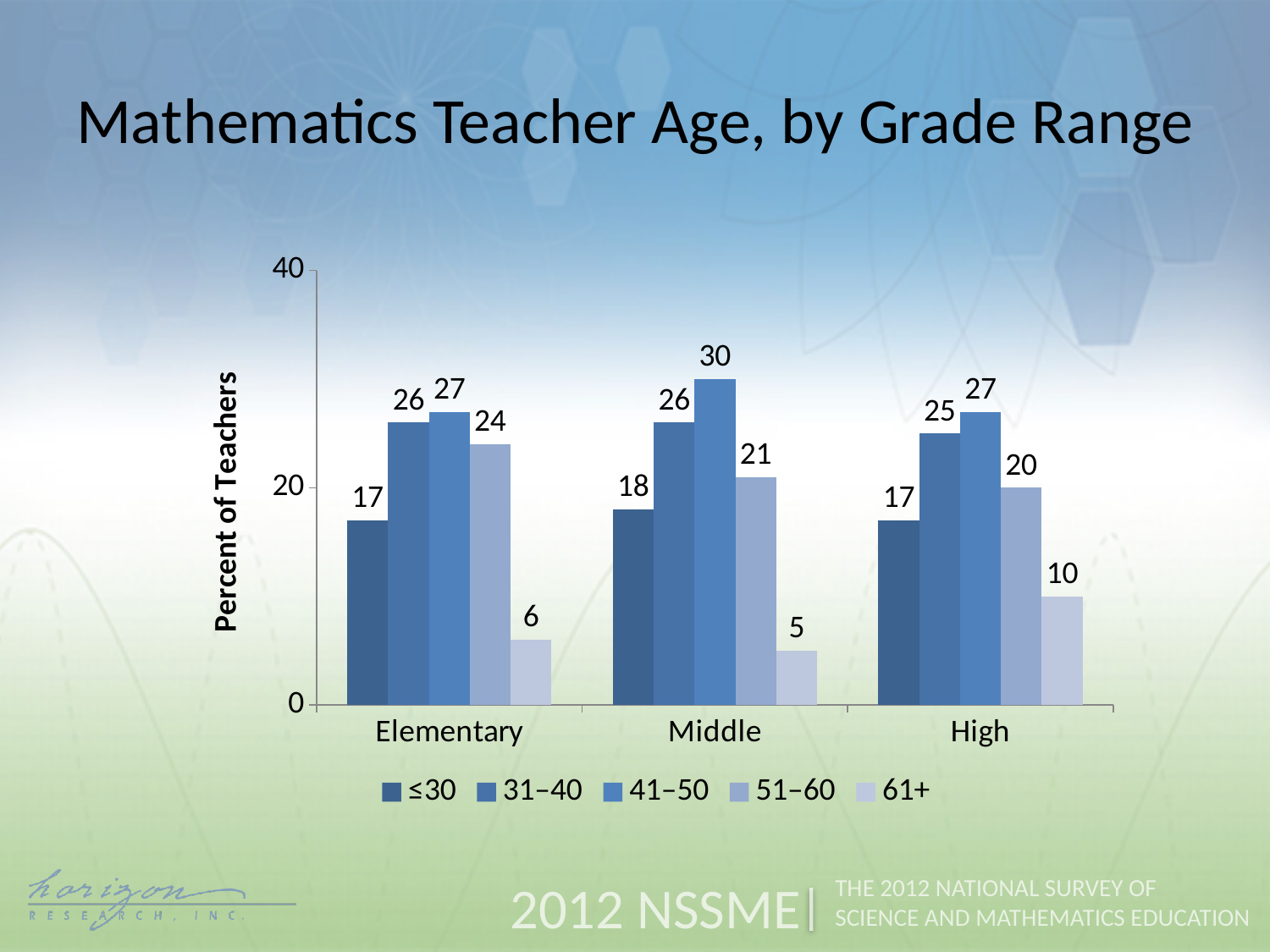
How many grade ranges are shown on the x axis? 3 What is the title of the chart? Mathematics Teacher Age, by Grade Range What kind of chart is shown on the slide? Bar chart What percent of high school mathematics teachers are aged 51–60? 20 Which grade range has the lowest value for the 61+ age group? Middle How many age groups does the legend list? 5 What is the difference between the 51–60 values for Elementary and High? 4 What is the label of the y axis? Percent of Teachers Which grade range has the highest value for the 41–50 age group? Middle What is the value for the 61+ age group among elementary mathematics teachers? 6 Is the value for the 31–40 age group larger for Middle or High? Middle What percent of middle school mathematics teachers are aged 41–50? 30